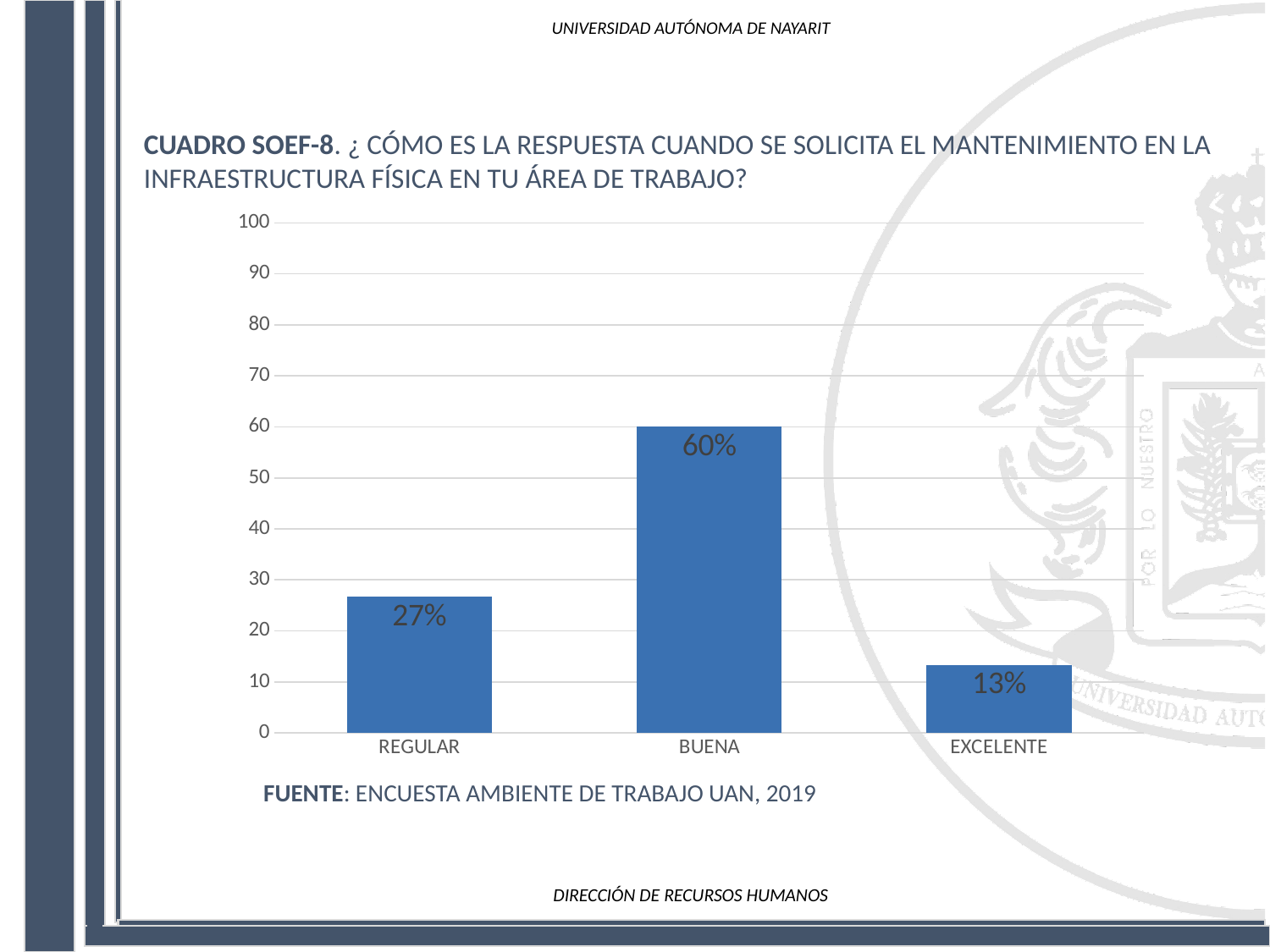
What is the difference between the values for REGULAR and EXCELENTE? 14% Which category has the lowest value? EXCELENTE Which is larger, the value for REGULAR or the value for EXCELENTE? REGULAR Is the value for BUENA greater or less than 50? greater What is the value for EXCELENTE? 13% What is the difference between the values for BUENA and REGULAR? 33% What is the source cited below the chart? ENCUESTA AMBIENTE DE TRABAJO UAN, 2019 Which category has the highest value? BUENA What is the value for REGULAR? 27% What is the value for BUENA? 60% How many categories are shown on the x axis? 3 What kind of chart is shown on the slide? bar chart